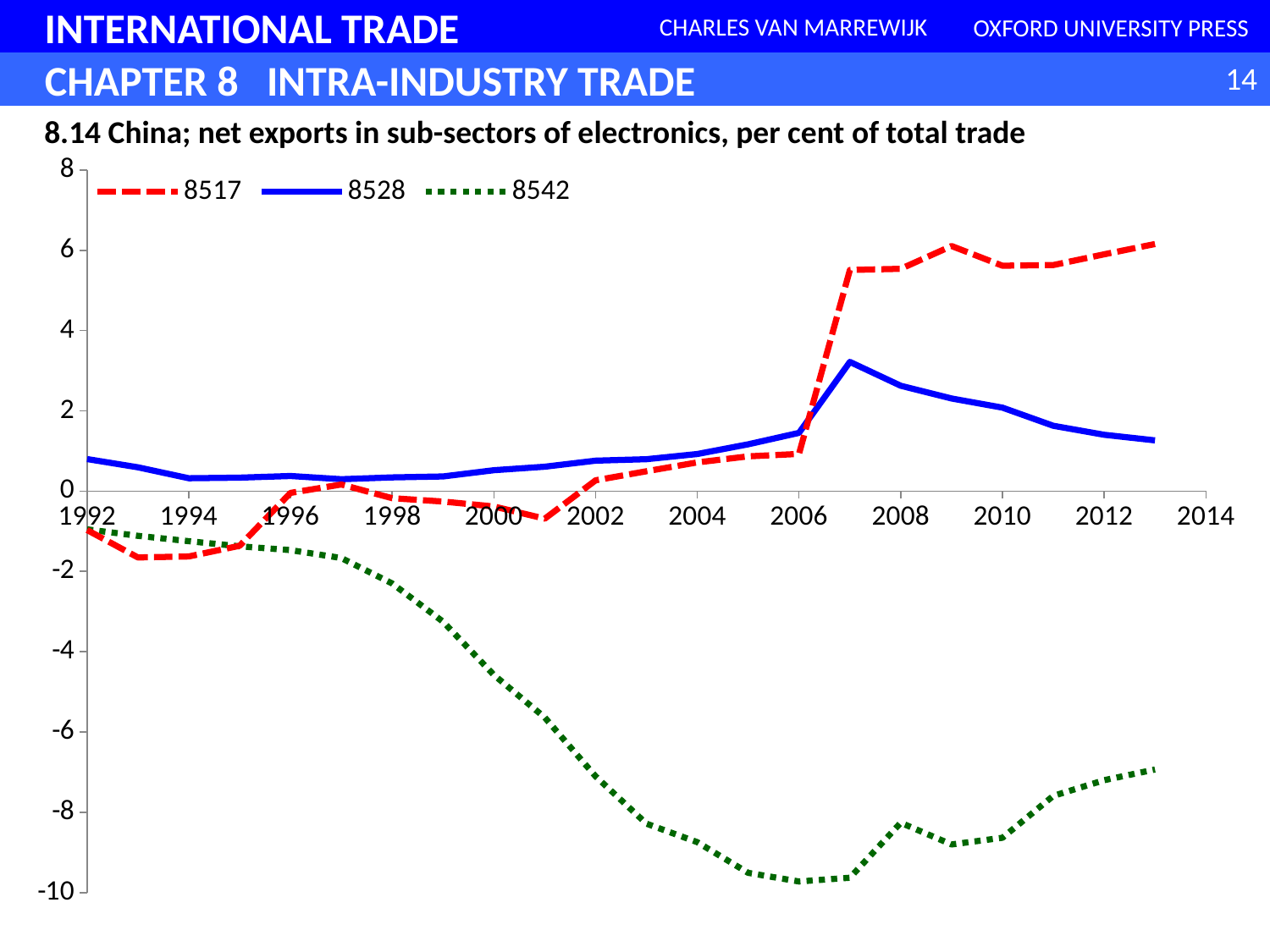
In 2013, which series has the higher value, 8517 or 8528? 8517 What are the series names listed in the legend? 8517, 8528, 8542 What kind of chart is shown on the slide? line chart Does the value for series 8542 rise or fall between 1992 and 2006? fall In 1994, which series has the higher value, 8517 or 8528? 8528 Which series has the lowest value in 2006? 8542 Is the value for series 8542 in 2013 greater or less than -8? greater What is the title of the chart? 8.14 China; net exports in sub-sectors of electronics, per cent of total trade How many series does the legend list? 3 Is the value for series 8517 in 2008 greater or less than 4? greater Is the value for series 8542 in 2006 greater or less than -8? less